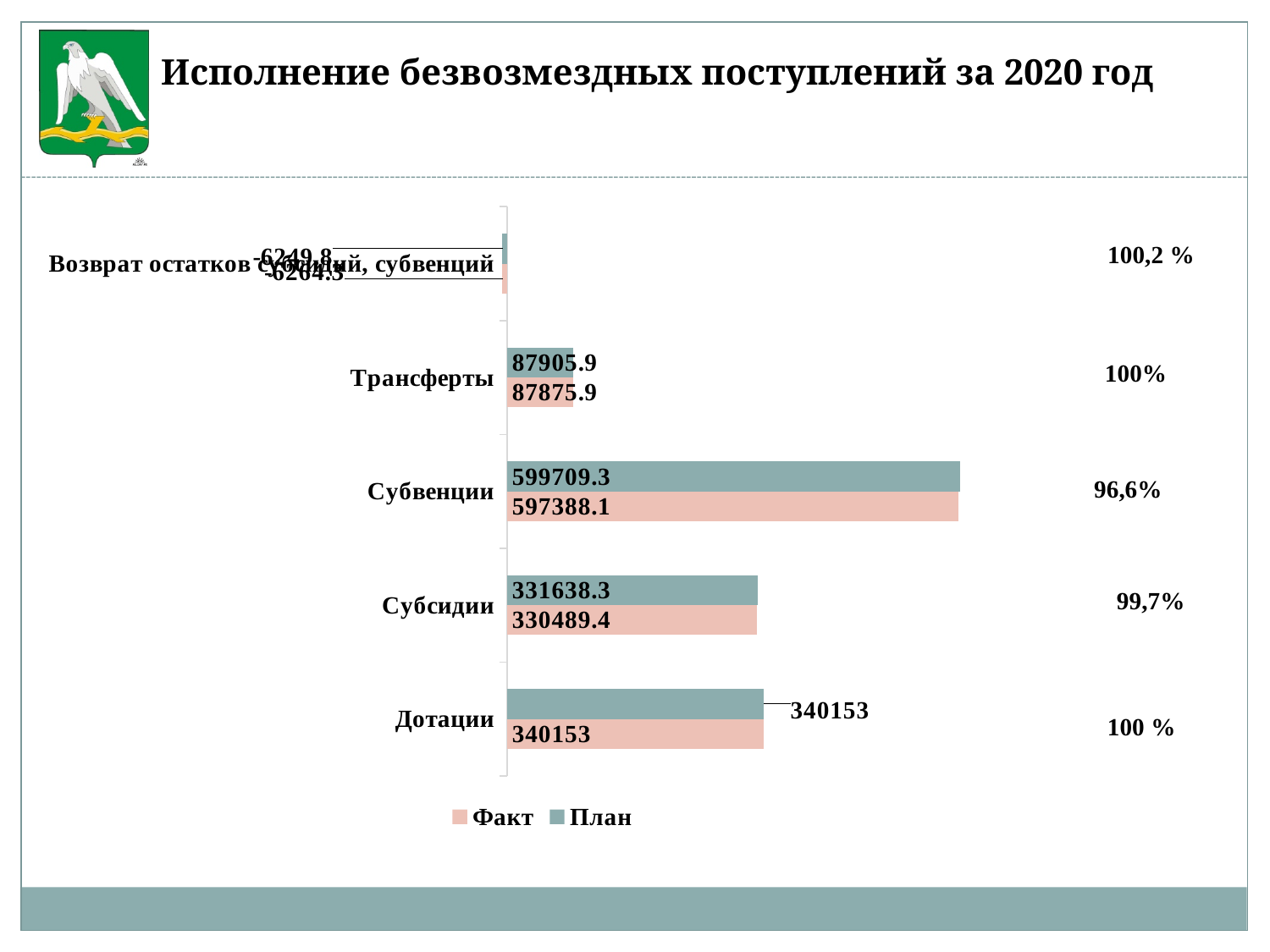
Which category has the highest План value? Субвенции Which series is shown in pink in the legend? Факт What is the Факт value for Трансферты? 87875.9 What type of chart is shown on the slide? bar chart Which is larger for Субвенции, the План value or the Факт value? План What is the План value for Дотации? 340153 How many series does the legend list? 2 What is the Факт value for Субсидии? 330489.4 What is the План value for Субвенции? 599709.3 What is the difference between the План and Факт values for Субсидии? 1148.9 How many categories are shown on the chart? 5 What percentage is shown next to the Субвенции bars? 96,6%